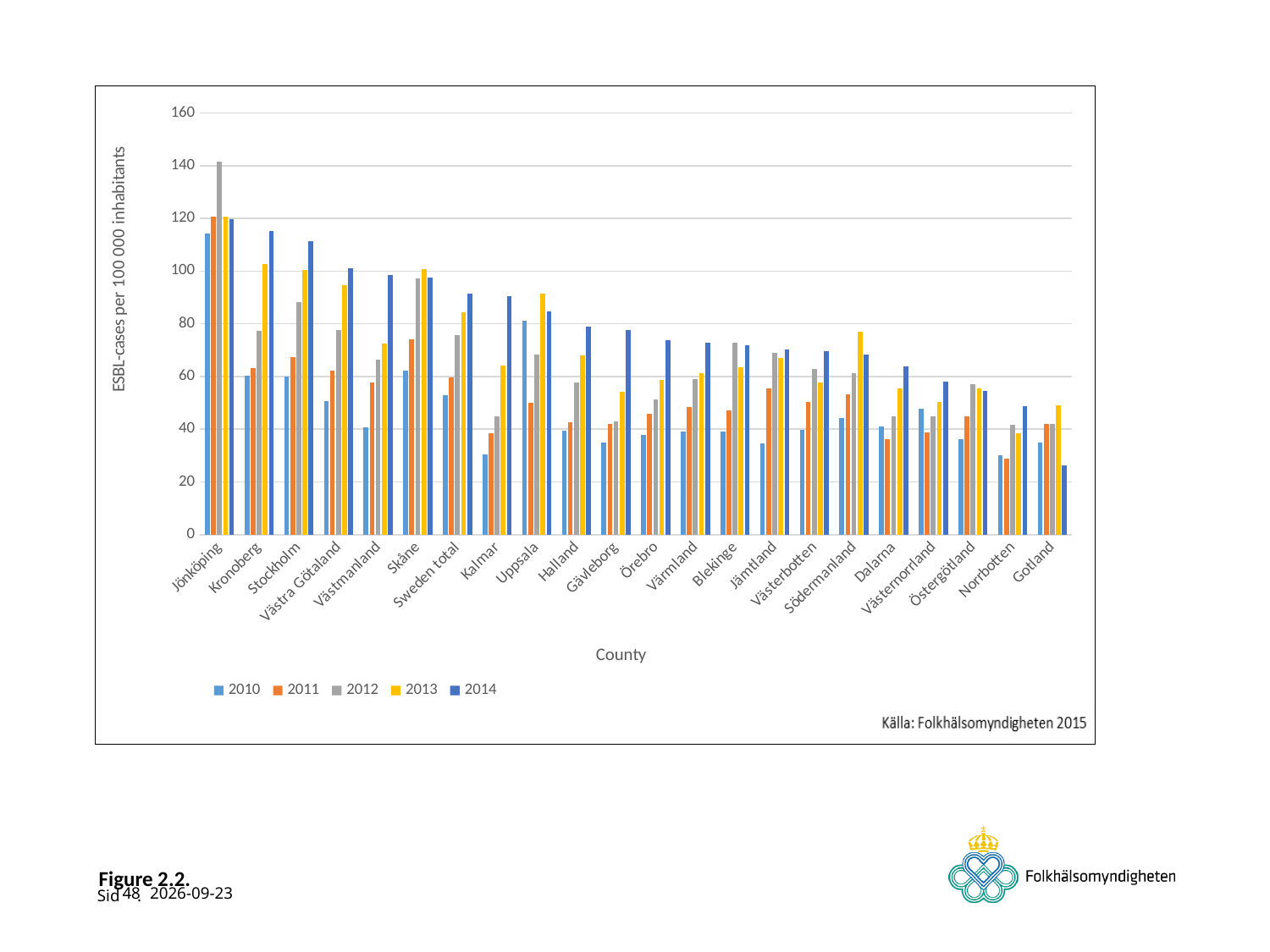
How many series does the legend list? 5 Which county has the highest 2013 value? Jönköping Is the 2014 value for Gotland greater or less than 40? less Which county has the highest 2012 value? Jönköping Is the 2014 value for Kronoberg greater or less than 100? greater How many counties (categories) are shown on the x axis? 22 Is the 2012 value for Jönköping greater or less than 120? greater Which county has the lowest 2014 value? Gotland What is the label of the y axis? ESBL-cases per 100 000 inhabitants What kind of chart is shown on the slide? bar chart For Uppsala, which is larger: the 2010 value or the 2011 value? 2010